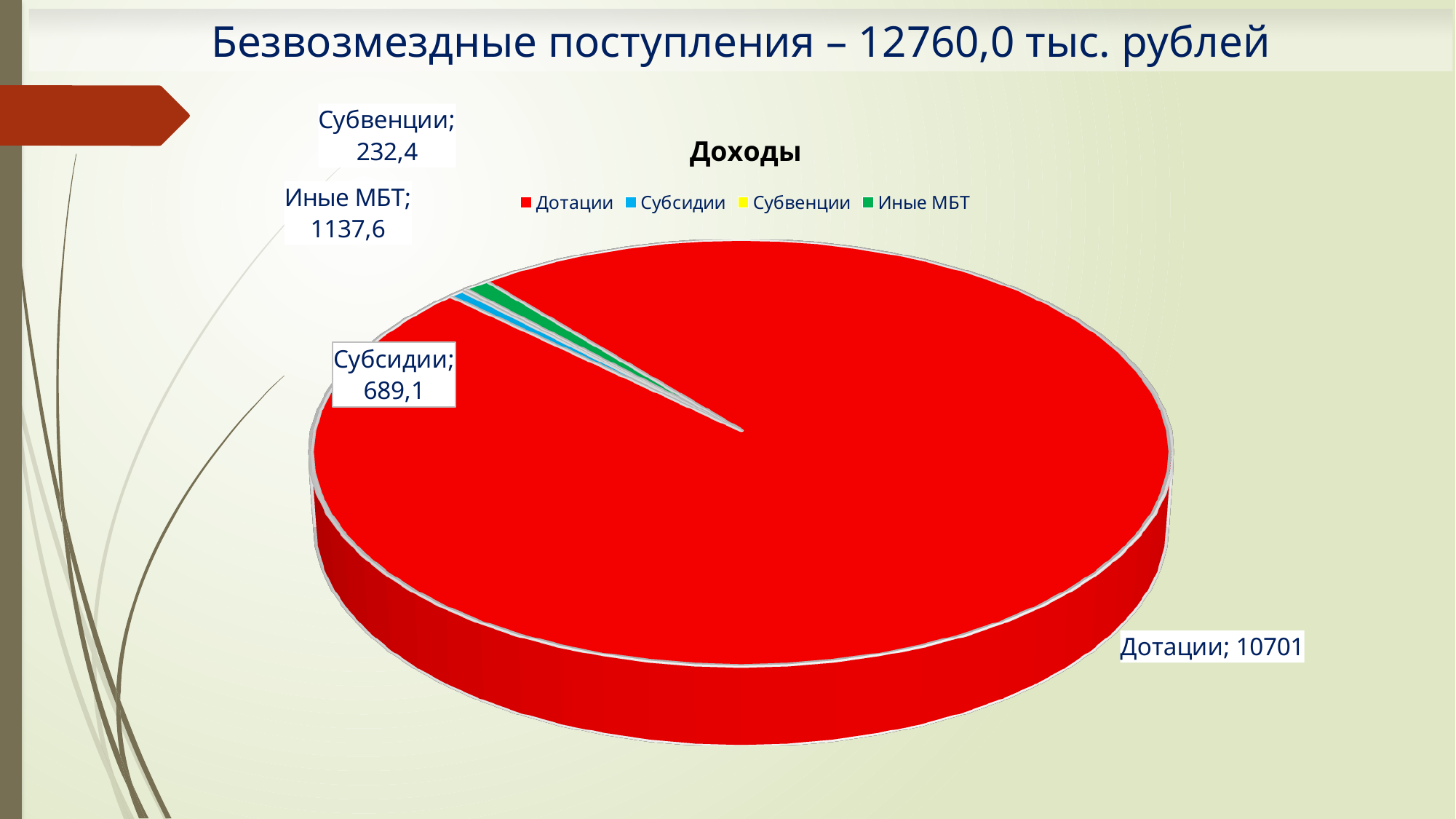
What is the value for Иные МБТ in the pie chart? 1137,6 What is the value for Субсидии in the pie chart? 689,1 Which category has the smallest value in the pie chart? Субвенции What is the title of the pie chart? Доходы How many categories are shown in the pie chart? 4 What kind of chart is shown on the slide? pie chart How many entries does the chart legend list? 4 Which category has the largest slice of the pie chart? Дотации What is the value for Субвенции in the pie chart? 232,4 What is the difference between the values for Иные МБТ and Субсидии? 448,5 Which is larger, Субсидии or Иные МБТ? Иные МБТ What is the value for Дотации in the pie chart? 10701